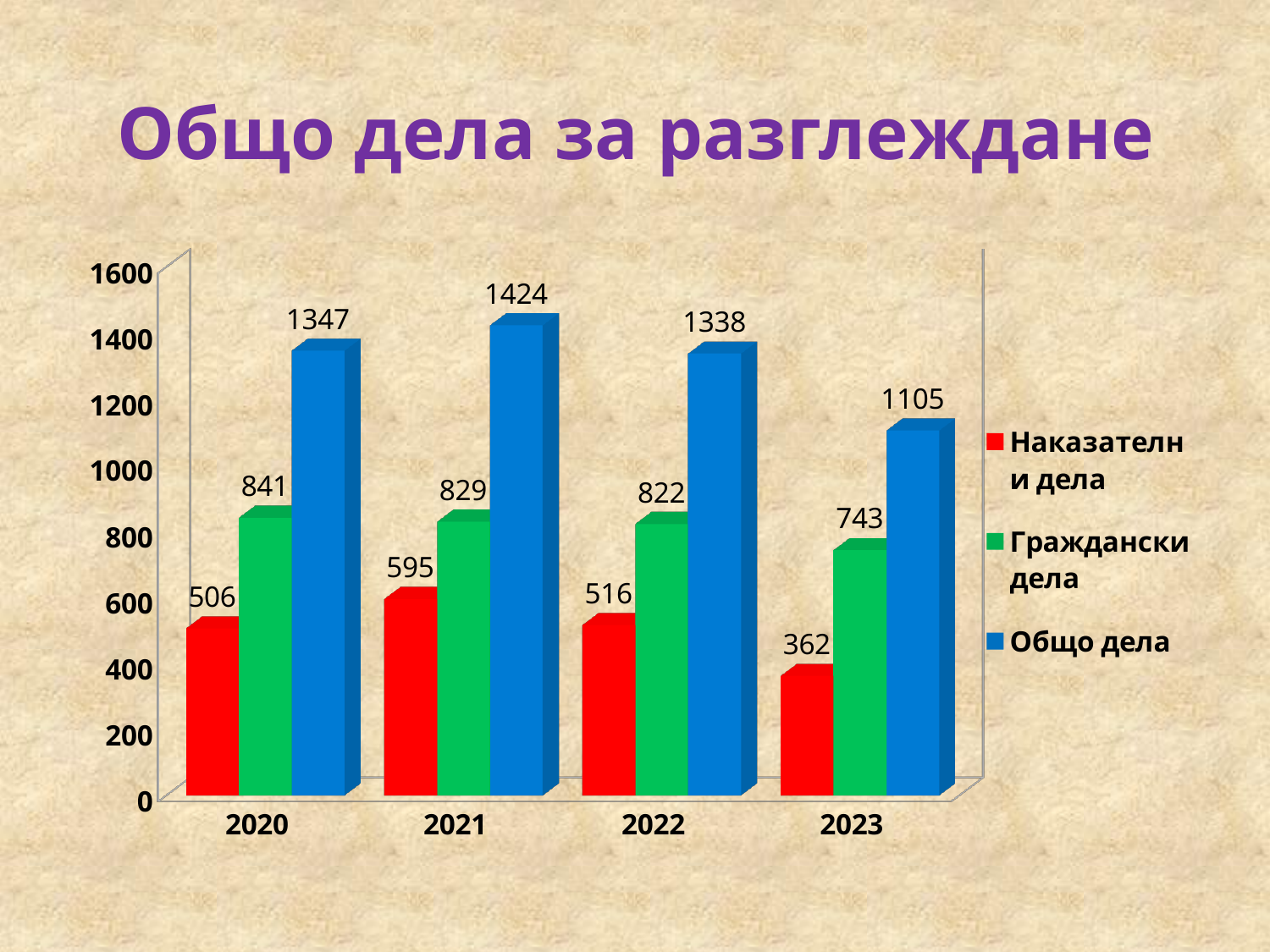
In which year is Общо дела highest? 2021 Is the value for Общо дела in 2023 greater or less than 1200? less What is the value for Общо дела in 2022? 1338 What kind of chart is shown on the slide? bar chart What is the title of the chart? Общо дела за разглеждане What is the difference between Общо дела in 2021 and in 2023? 319 What is the value for Наказателни дела in 2021? 595 Which is larger: Граждански дела in 2020 or Граждански дела in 2022? Граждански дела in 2020 In which year is Наказателни дела lowest? 2023 How many series does the legend list? 3 How many years are shown on the x axis? 4 What is the value for Граждански дела in 2023? 743